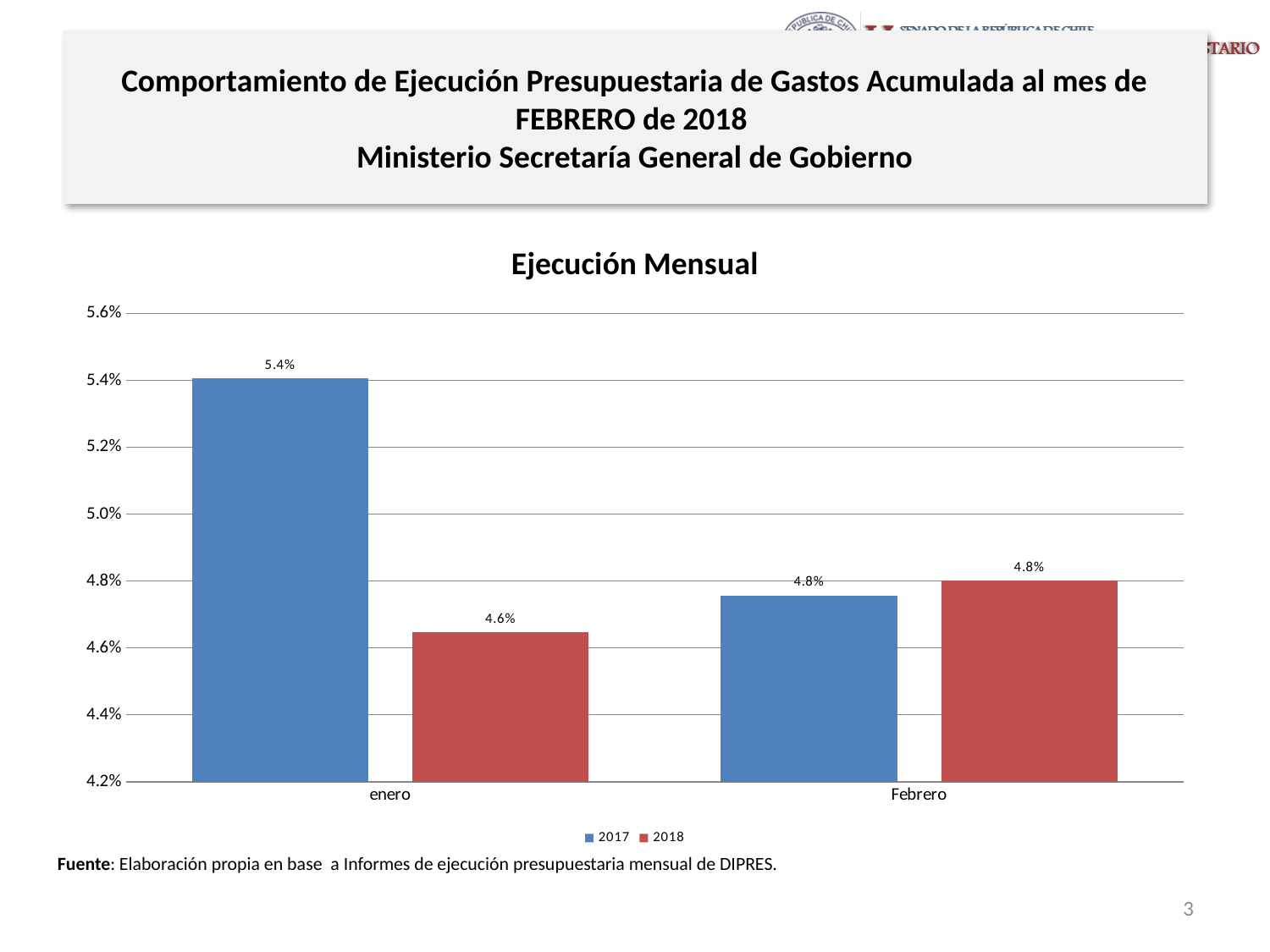
Which bar has the lowest value in the chart? 2018 in enero What is the value for 2017 in Febrero? 4.8% What is the value for 2018 in enero? 4.6% What is the value for 2017 in enero? 5.4% Does the 2017 series rise or fall from enero to Febrero? fall Is the value for 2017 in enero greater or less than 5.0%? greater What is the difference between the 2017 and 2018 values in enero? 0.8% How many series does the legend list? 2 Which is larger in enero, the 2017 value or the 2018 value? 2017 What is the value for 2018 in Febrero? 4.8% Which bar has the highest value in the chart? 2017 in enero What kind of chart is shown? bar chart